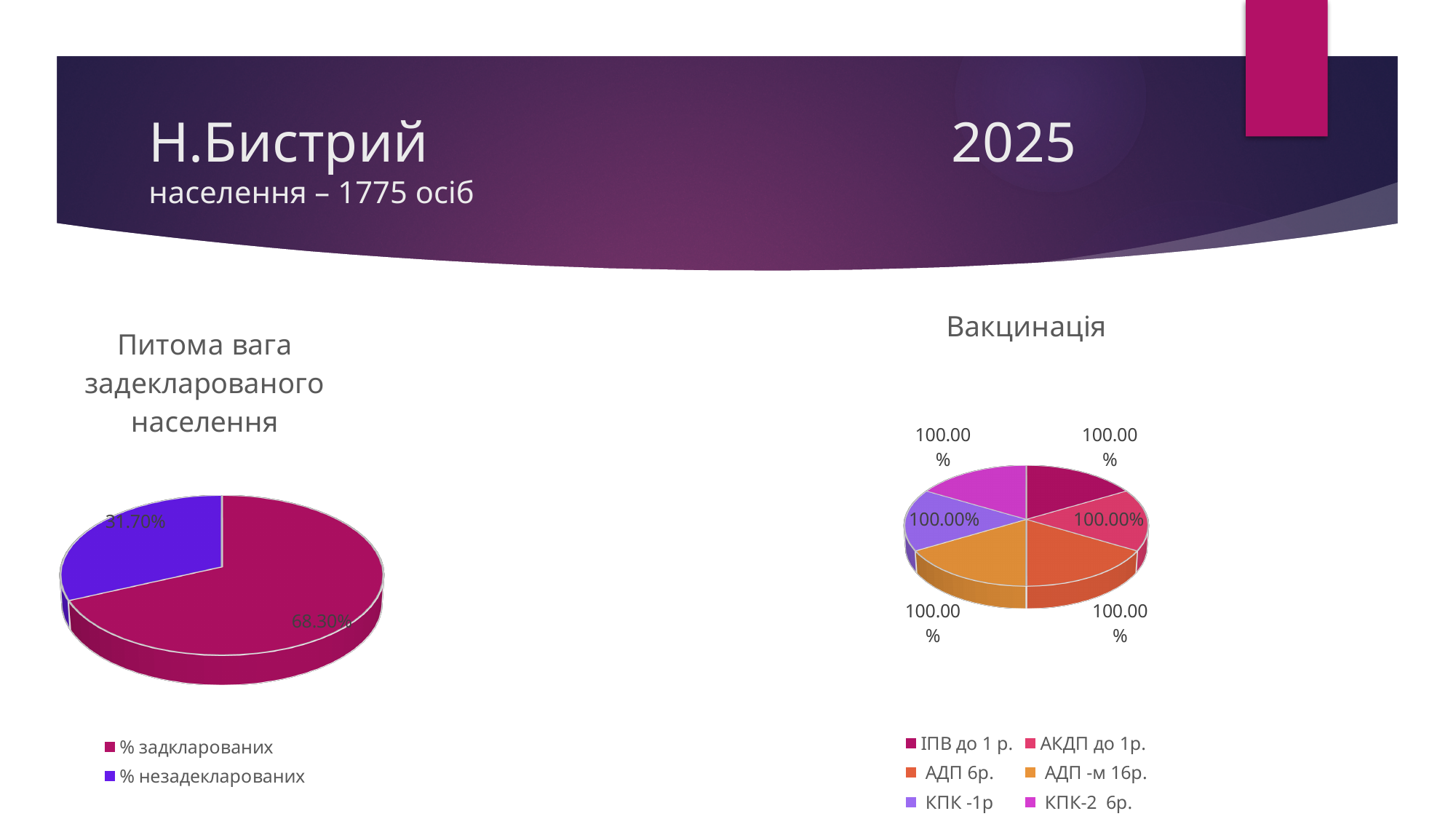
What kind of chart is the chart titled "Вакцинація"? Pie chart In the chart titled "Вакцинація", what colour is the slice for "АДП -м 16р."? Orange In the chart titled "Питома вага задекларованого населення", which category has the largest slice? % задкларованих In the chart titled "Вакцинація", what is the value labelled for "ІПВ до 1 р."? 100.00% What kind of chart is the chart titled "Питома вага задекларованого населення"? Pie chart In the chart titled "Питома вага задекларованого населення", which is larger: "% задклларованих" or "% незадекларованих"? % задкларованих In the chart titled "Питома вага задекларованого населення", which category has the smallest slice? % незадекларованих In the chart titled "Вакцинація", how many categories does the legend list? 6 In the chart titled "Питома вага задекларованого населення", what is the value for "% незадекларованих"? 31.70% In the chart titled "Питома вага задекларованого населення", what is the difference between the values for "% задклларованих" and "% незадекларованих"? 36.60% In the chart titled "Питома вага задекларованого населення", what is the value for "% задклларованих"? 68.30% In the chart titled "Питома вага задекларованого населення", how many categories does the legend list? 2